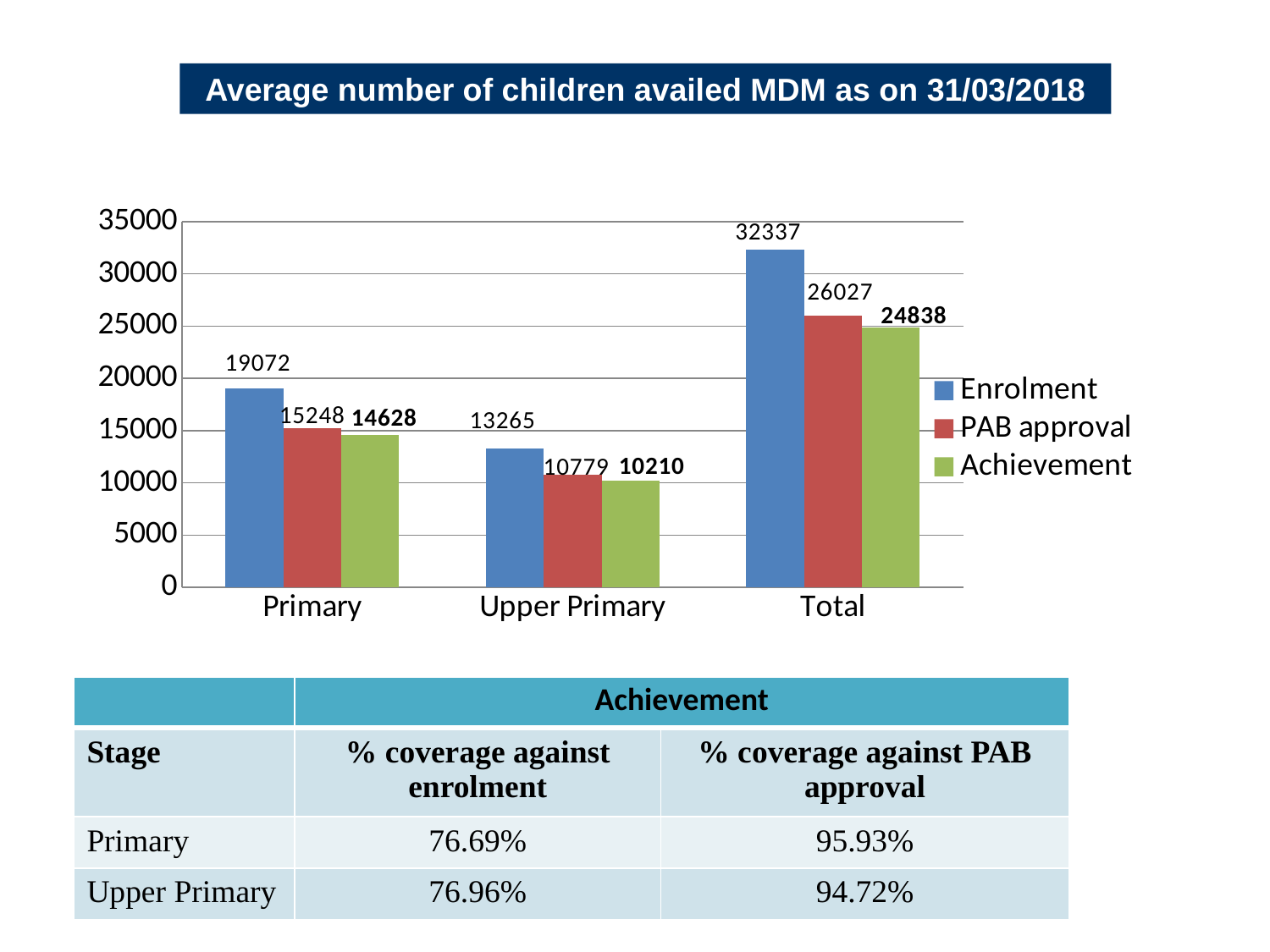
What is the difference between Enrolment and PAB approval for Total? 6310 What is the PAB approval value for Upper Primary? 10779 How many series does the legend list? 3 Which category has the lowest Achievement value? Upper Primary What is the Achievement value for Total? 24838 What is the Enrolment value for Primary? 19072 Which category has the highest Enrolment value? Total What is the difference between PAB approval and Achievement for Primary? 620 What kind of chart is shown on the slide? Bar chart Which series is shown in green in the legend? Achievement How many categories are shown on the x axis? 3 Which is larger, the Achievement value for Primary or the Enrolment value for Upper Primary? Achievement value for Primary